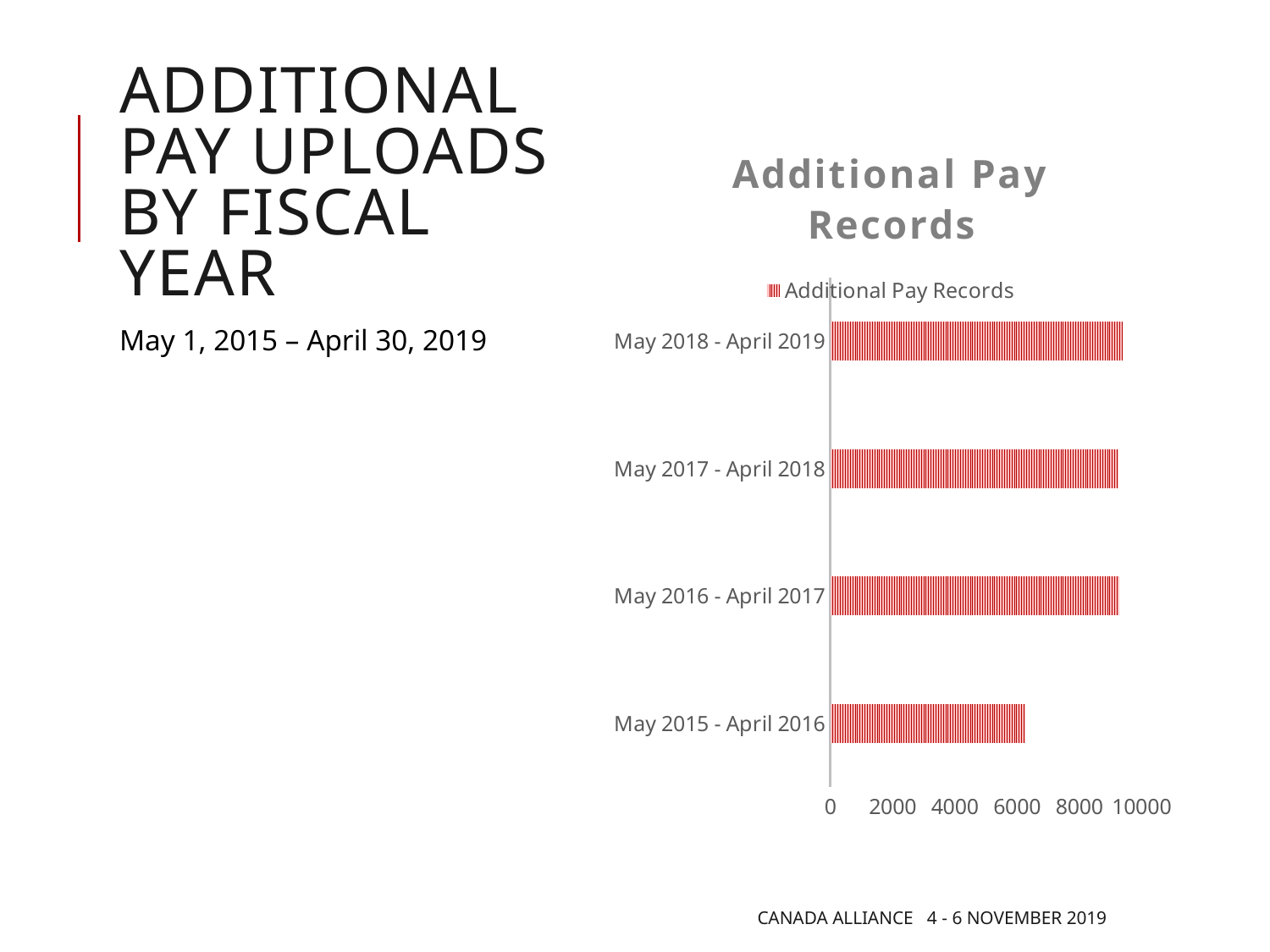
How many series does the chart legend list? 1 Is the value for May 2016 - April 2017 greater or less than 10000? less What kind of chart is shown on the slide? bar chart What is the name of the series shown in the chart legend? Additional Pay Records Which is larger, the value for May 2015 - April 2016 or the value for May 2018 - April 2019? May 2018 - April 2019 Is the value for May 2015 - April 2016 greater or less than 8000? less Which fiscal year has the lowest number of Additional Pay Records? May 2015 - April 2016 Which is larger, the value for May 2015 - April 2016 or the value for May 2017 - April 2018? May 2017 - April 2018 What is the title of the chart? Additional Pay Records Is the value for May 2015 - April 2016 greater or less than 4000? greater How many fiscal-year categories are plotted in the chart? 4